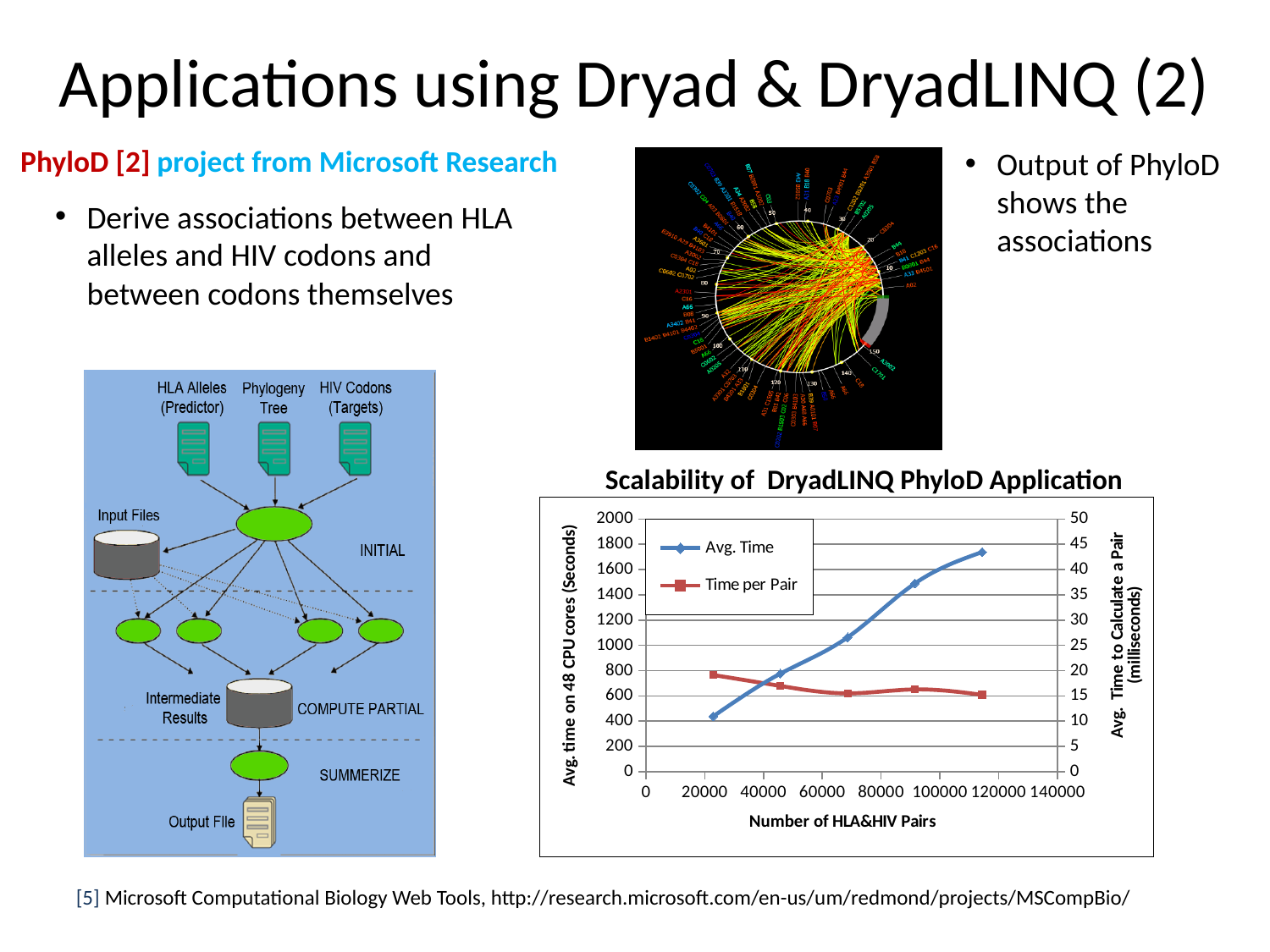
In the 'Scalability of DryadLINQ PhyloD Application' chart, is the Avg. Time at the largest number of pairs greater or less than 1600 seconds? greater What is the label of the x axis in the 'Scalability of DryadLINQ PhyloD Application' chart? Number of HLA&HIV Pairs How many data points does the Avg. Time series have in the 'Scalability of DryadLINQ PhyloD Application' chart? 5 In the 'Scalability of DryadLINQ PhyloD Application' chart, is the Time per Pair at the smallest number of pairs greater or less than 15 milliseconds? greater In the 'Scalability of DryadLINQ PhyloD Application' chart, does the Avg. Time series rise or fall as the number of HLA&HIV pairs increases? rise In the 'Scalability of DryadLINQ PhyloD Application' chart, what are the two series named in the legend? Avg. Time and Time per Pair In the 'Scalability of DryadLINQ PhyloD Application' chart, is the Time per Pair at the largest number of pairs greater or less than 20 milliseconds? less What kind of chart is 'Scalability of DryadLINQ PhyloD Application'? line chart How many series does the legend of the 'Scalability of DryadLINQ PhyloD Application' chart list? 2 In the 'Scalability of DryadLINQ PhyloD Application' chart, is the Avg. Time larger at the smallest or at the largest number of HLA&HIV pairs? at the largest number of pairs In the 'Scalability of DryadLINQ PhyloD Application' chart, does the Time per Pair series generally rise or fall as the number of HLA&HIV pairs increases? fall